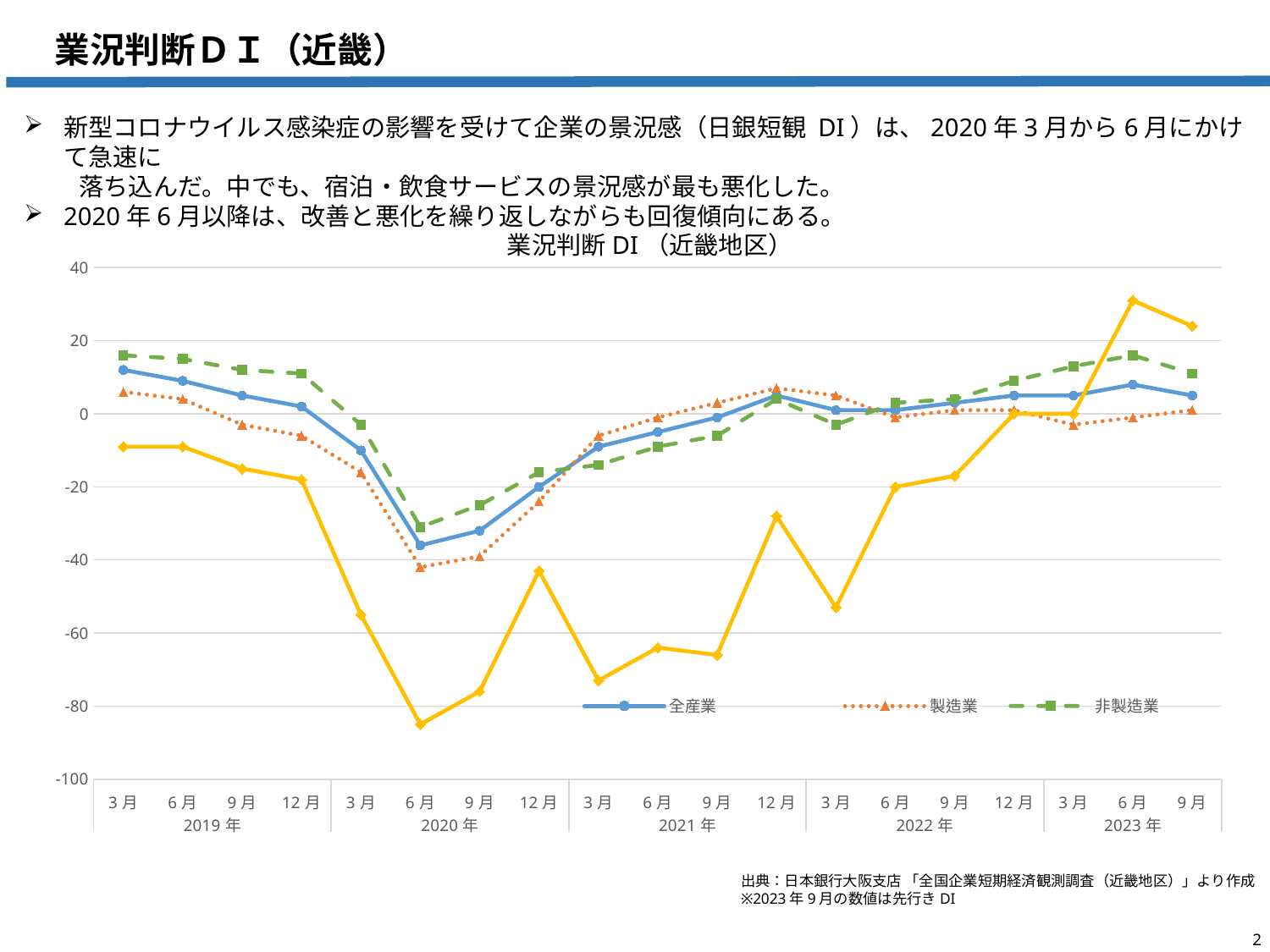
Is the value for 製造業 in 2020年6月 greater or less than -40? less What kind of chart is shown on the slide? line chart In 2020年6月, which is higher, 製造業 or 非製造業? 非製造業 Is the value for 非製造業 in 2019年3月 greater or less than 20? less Which series does the legend list first? 全産業 Is the value for 全産業 in 2020年6月 greater or less than -40? greater How many series does the chart legend list? 3 Does the 全産業 series rise or fall from 2019年3月 to 2020年6月? fall How many time points are plotted along the x axis? 19 At which time point is the 製造業 series at its lowest? 2020年6月 What is the title of the chart? 業況判断DI（近畿地区）